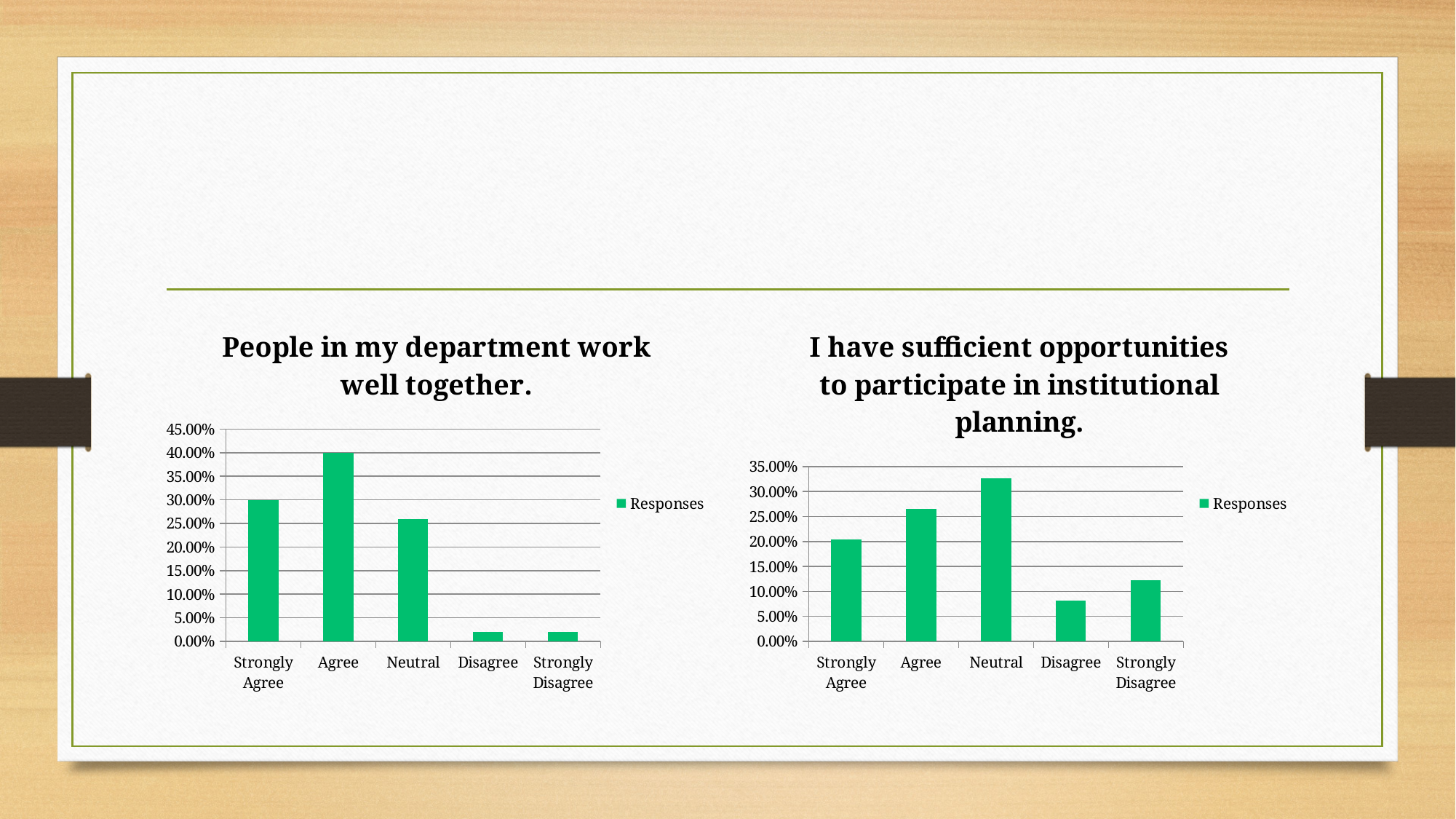
On the chart titled "People in my department work well together.", is the value for Neutral greater or less than 25.00%? greater On the chart titled "I have sufficient opportunities to participate in institutional planning.", which category has the lowest value? Disagree On the chart titled "People in my department work well together.", which category has the highest value? Agree On the chart titled "People in my department work well together.", is the value for Disagree greater or less than 5.00%? less On the chart titled "I have sufficient opportunities to participate in institutional planning.", is the value for Strongly Disagree greater or less than 15.00%? less On the chart titled "I have sufficient opportunities to participate in institutional planning.", which is larger, Agree or Strongly Disagree? Agree What type of chart is the chart titled "I have sufficient opportunities to participate in institutional planning."? Bar chart On the chart titled "People in my department work well together.", which is larger, Strongly Agree or Neutral? Strongly Agree How many categories are shown on the x axis of the chart titled "People in my department work well together."? 5 On the chart titled "People in my department work well together.", what is the value for Agree? 40.00% On the chart titled "I have sufficient opportunities to participate in institutional planning.", which category has the highest value? Neutral